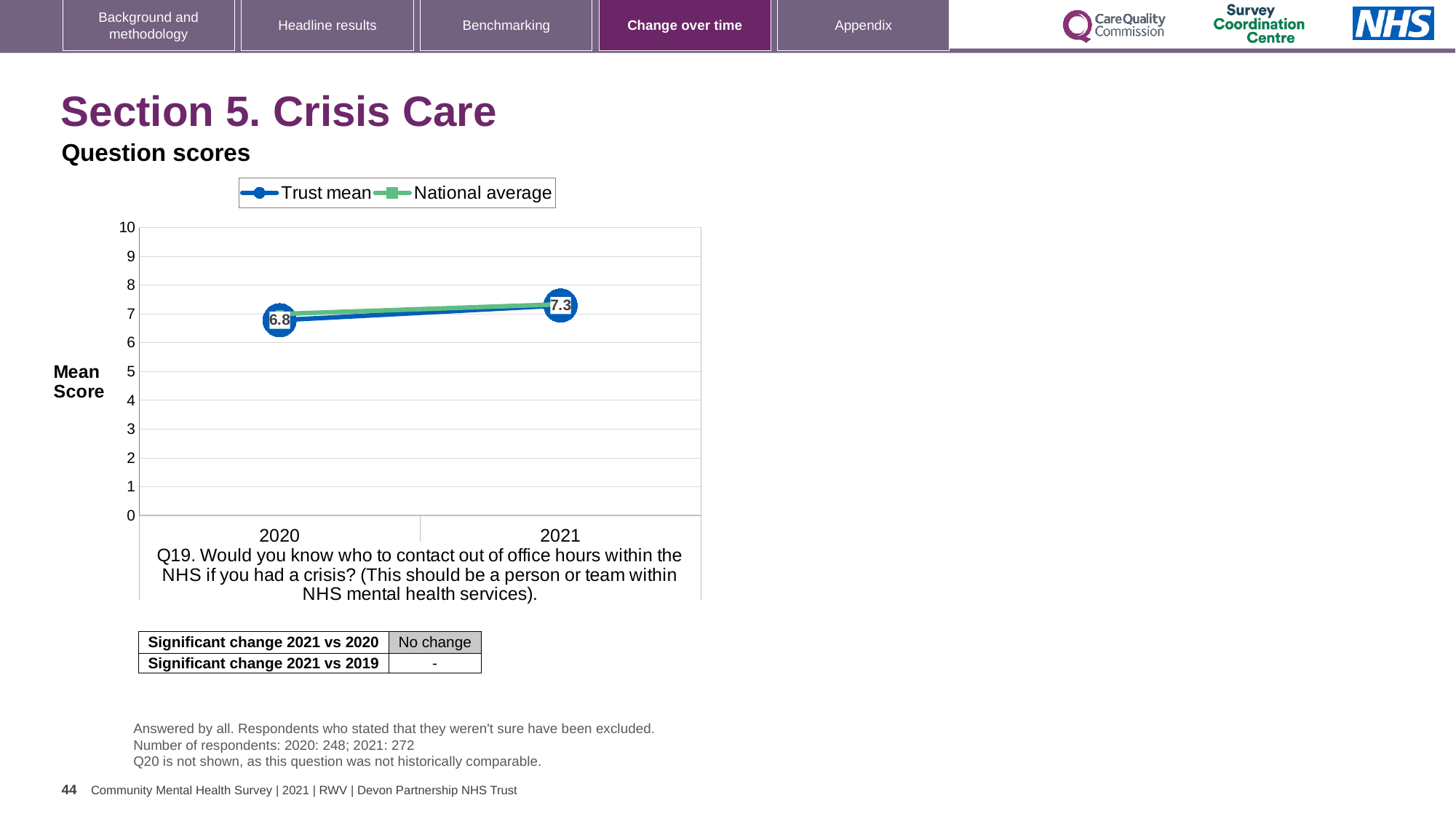
What is the label on the y axis of the chart? Mean Score What is the Trust mean score for 2020? 6.8 What kind of chart is shown on the slide? line chart Is the National average value for 2020 greater or less than 5? greater Does the Trust mean score rise or fall from 2020 to 2021? rise Which year has the higher Trust mean score, 2020 or 2021? 2021 Which series is shown in green in the chart legend? National average By how much did the Trust mean score change from 2020 to 2021? 0.5 What is the Trust mean score for 2021? 7.3 How many years are plotted on the x axis of the chart? 2 How many series does the chart legend list? 2 Is the National average value for 2021 greater or less than 8? less